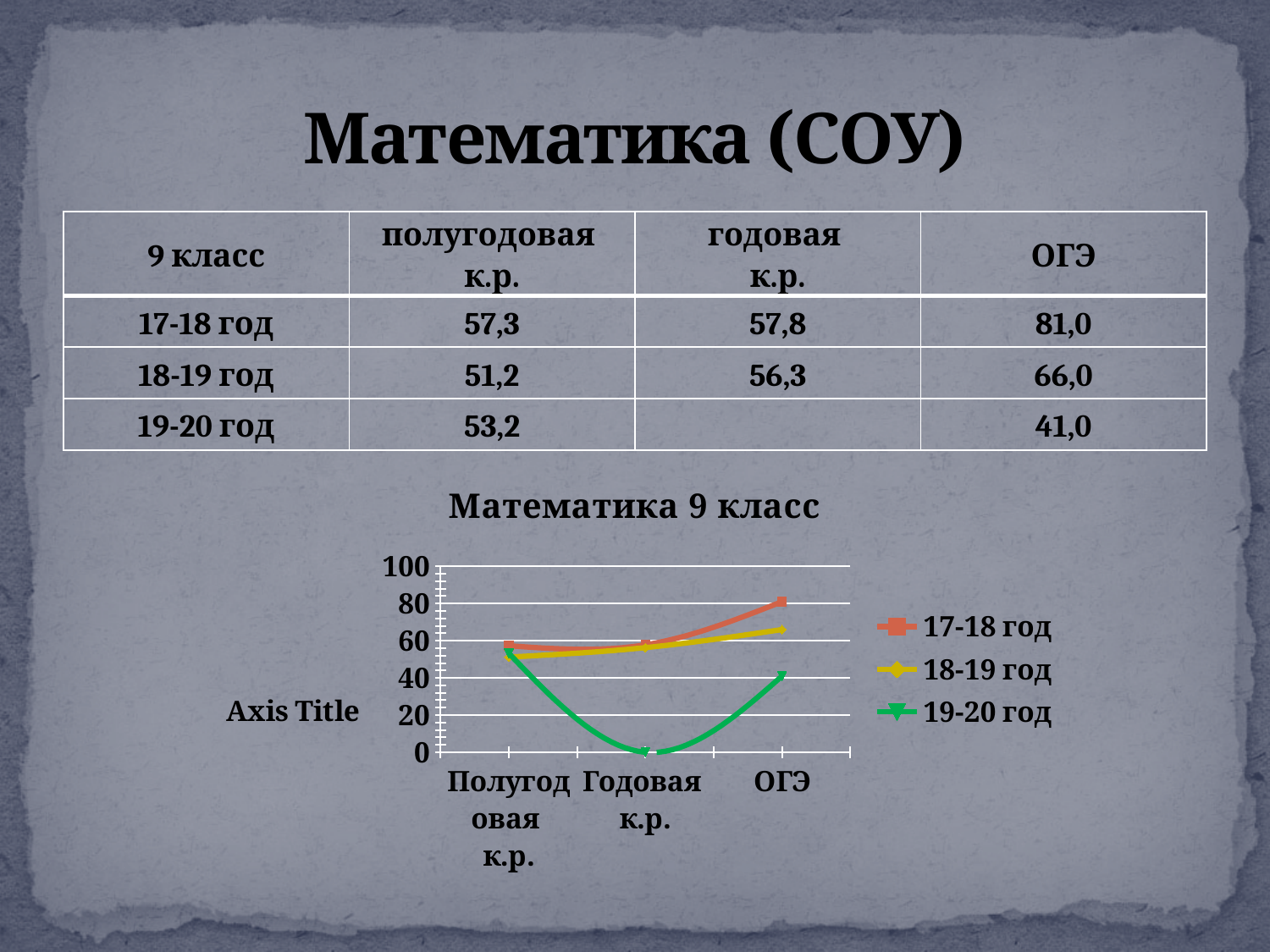
In the "Математика 9 класс" chart, does the 17-18 год line rise or fall from Полугодовая к.р. to ОГЭ? rises What is the difference between the ОГЭ values for 17-18 год and 18-19 год shown on the slide? 15,0 What kind of chart is shown under the title "Математика 9 класс"? line chart In the "Математика 9 класс" chart, is the value for 17-18 год at ОГЭ greater or less than 60? greater What is the ОГЭ value for 17-18 год shown on the slide? 81,0 How many categories are on the x axis of the "Математика 9 класс" chart? 3 In the "Математика 9 класс" chart, is the value for 19-20 год at ОГЭ greater or less than 60? less How many series does the legend of the "Математика 9 класс" chart list? 3 In the "Математика 9 класс" chart, which series has the highest value at ОГЭ? 17-18 год What is the title of the chart on the slide? Математика 9 класс In the "Математика 9 класс" chart, does the 19-20 год line rise or fall from Полугодовая к.р. to Годовая к.р.? falls In the "Математика 9 класс" chart, which series has the lowest value at ОГЭ? 19-20 год